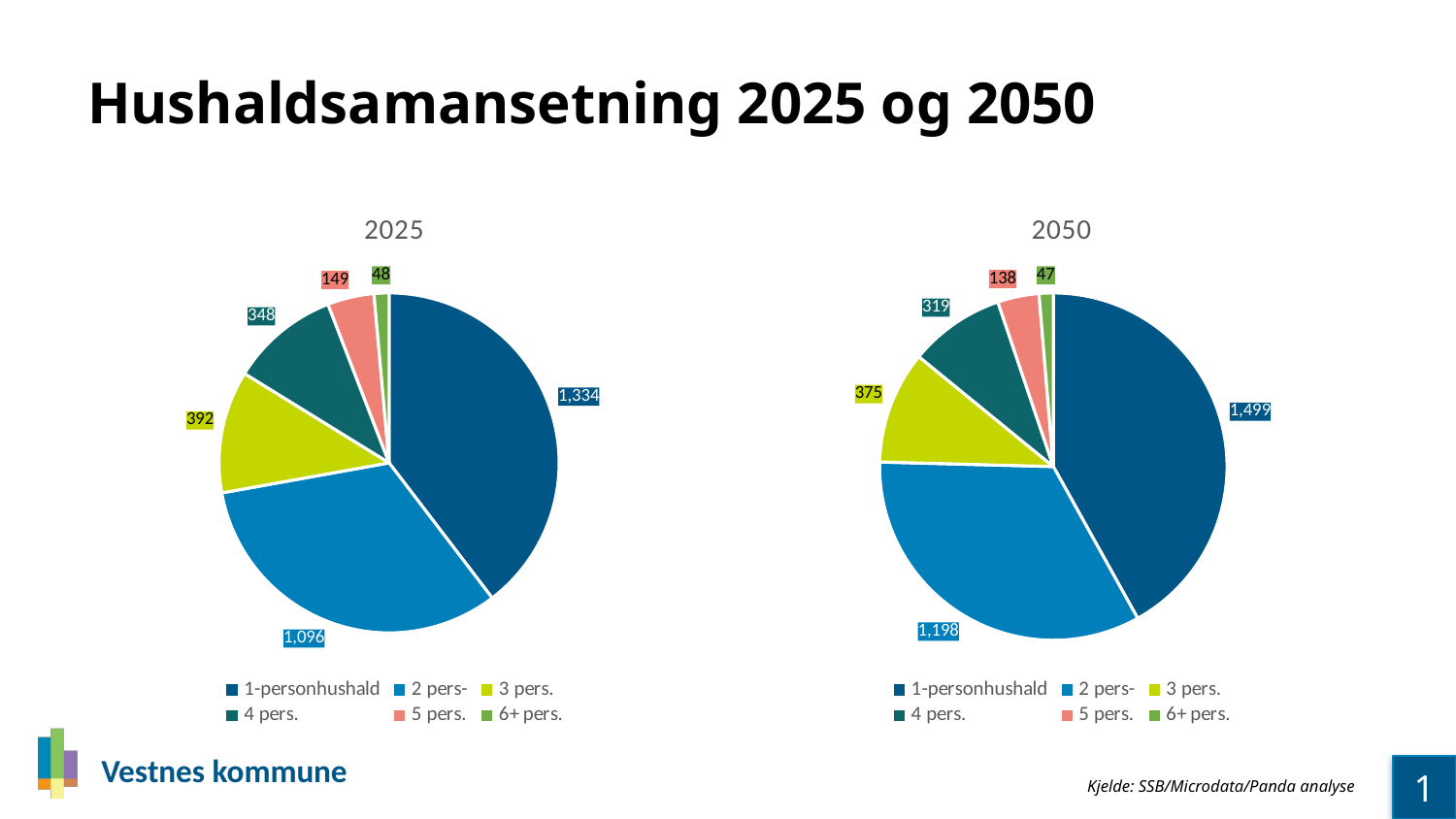
In the 2025 pie chart, which is larger: 3 pers. or 4 pers.? 3 pers. What is the title of the slide containing the two pie charts? Hushaldsamansetning 2025 og 2050 What is the total of all slices in the 2025 pie chart? 3,367 What type of chart is used for 2025 and 2050 on this slide? Pie chart What is the difference between the 1-personhushald values in the 2050 and 2025 pie charts? 165 In the 2050 pie chart, what is the value for 2 pers-? 1,198 How many categories does the 2050 pie chart show? 6 In the 2025 pie chart, what is the value for 1-personhushald? 1,334 In the 2050 pie chart, what is the value for 6+ pers.? 47 In the 2050 pie chart, which category has the largest slice? 1-personhushald In the 2025 pie chart, which category has the smallest slice? 6+ pers. In the 2025 pie chart, what is the value for 4 pers.? 348